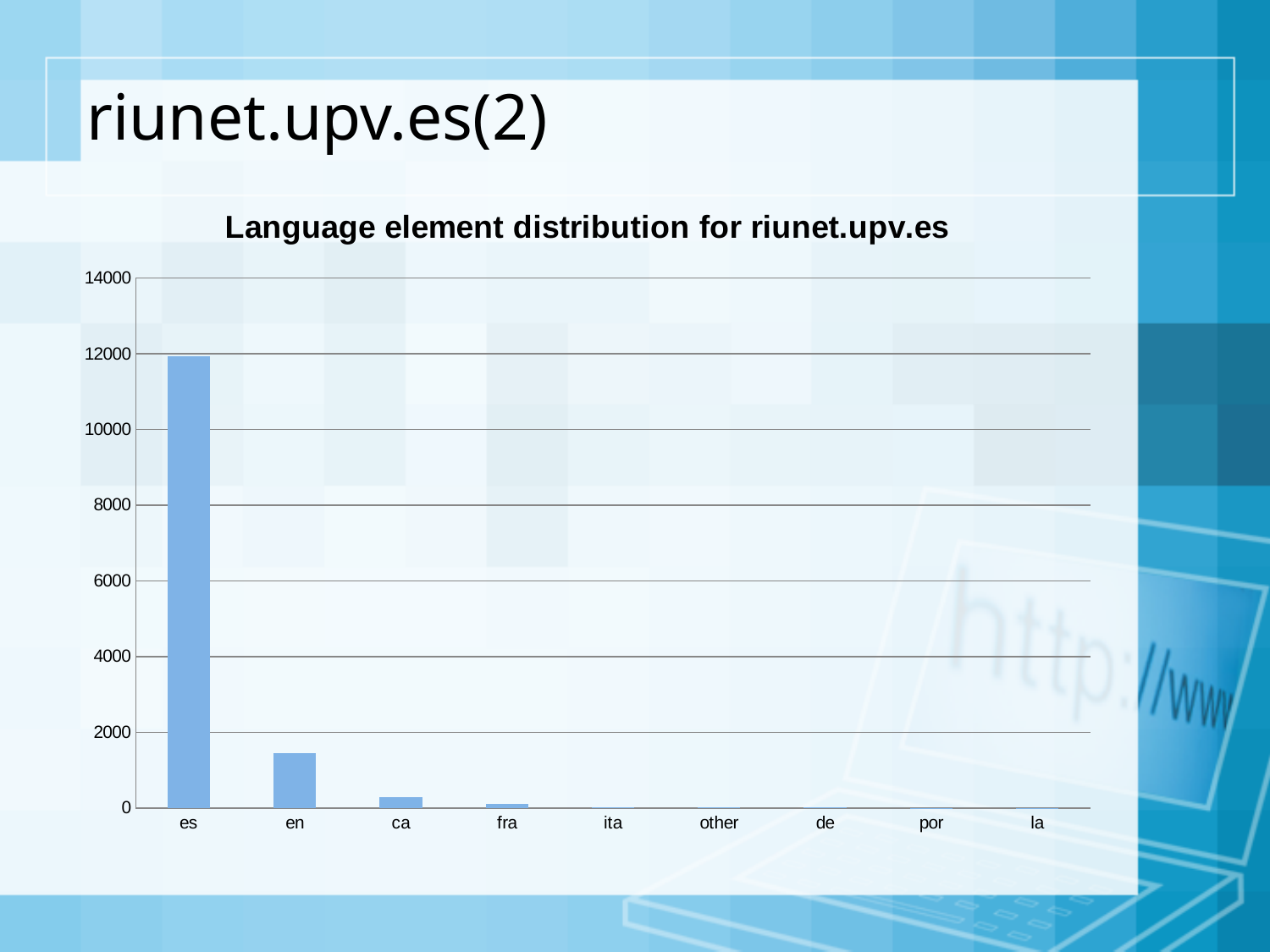
Which is larger, the value for es or the value for en? es How many language categories are shown on the x axis? 9 Which category is listed first on the x axis? es Is the value for ca greater or less than 1000? less Do the values rise or fall moving from es to la along the x axis? fall Which is larger, the value for en or the value for ca? en Is the value for en greater or less than 2000? less What is the title of the chart? Language element distribution for riunet.upv.es What kind of chart is shown on the slide? bar chart Which language has the highest value? es Is the value for es greater or less than 10000? greater